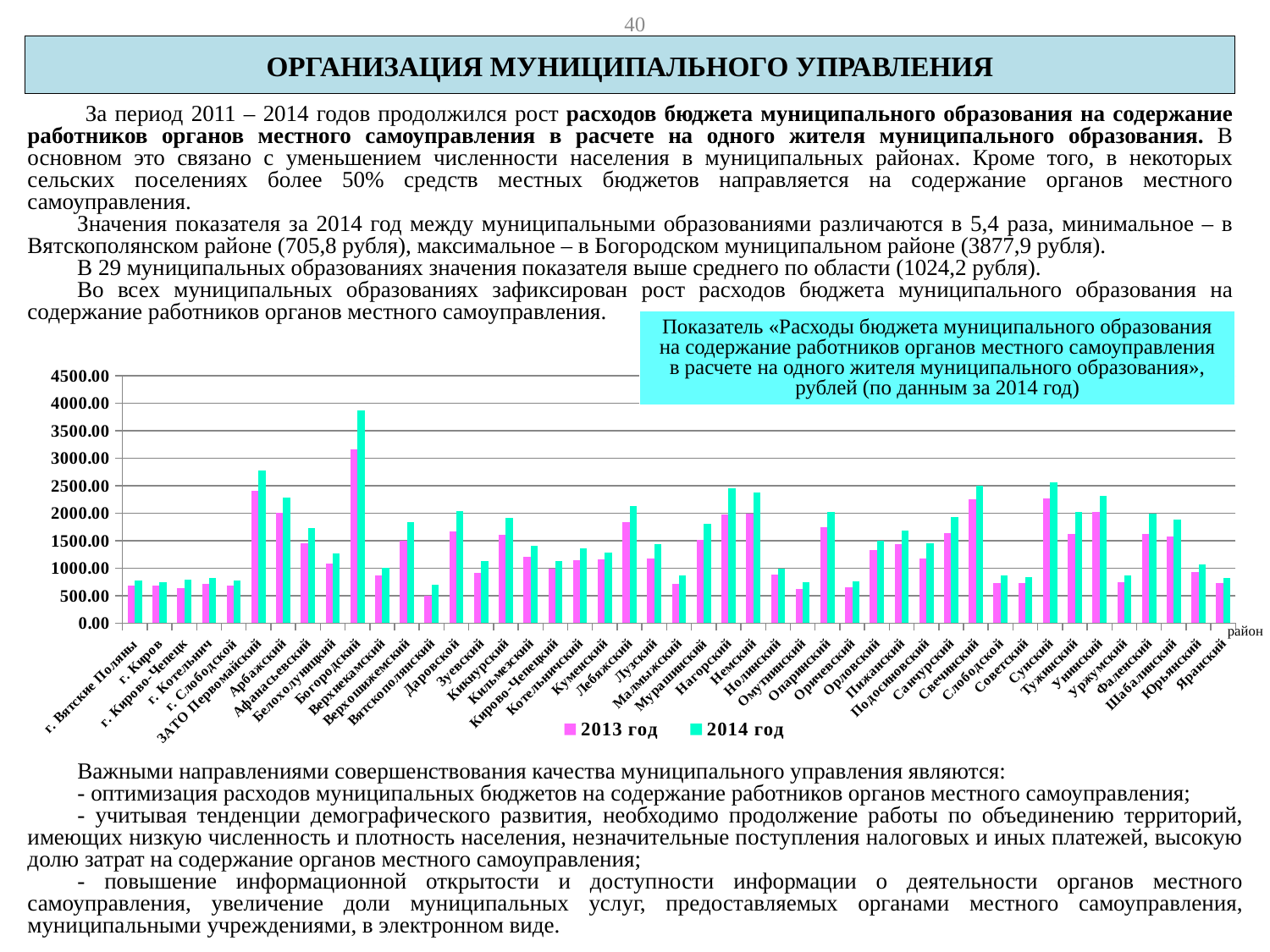
Is the 2014 год value for г. Киров greater or less than 1000? less For Богородский, which is larger: the 2013 год value or the 2014 год value? 2014 год Is the 2014 год value for Богородский greater or less than 3500? greater What kind of chart is shown on the slide? bar chart Which has the larger 2013 год value: Богородский or Арбажский? Богородский How many municipalities are shown along the x axis of the chart? 45 Is the 2013 год value for Вятскополянский greater or less than 1000? less Which municipality has the lowest value for 2014 год in the chart? Вятскополянский What are the two series named in the chart legend? 2013 год and 2014 год How many series does the chart legend list? 2 Which municipality has the highest value for 2014 год in the chart? Богородский